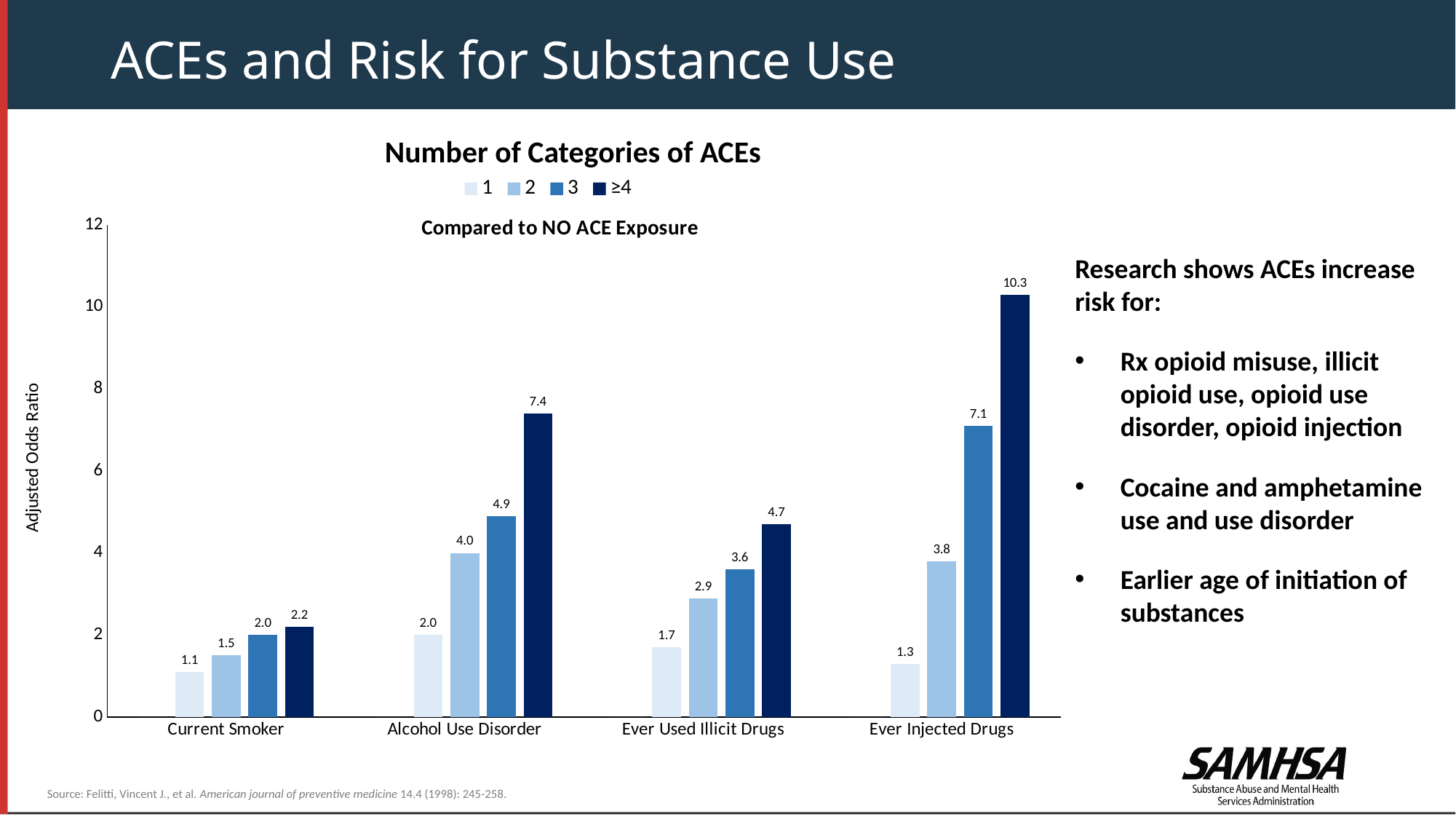
What kind of chart is shown on the slide? Bar chart Within the Ever Used Illicit Drugs category, do the values rise or fall as the number of ACE categories increases? Rise What is the adjusted odds ratio for Alcohol Use Disorder with 2 categories of ACEs? 4.0 What is the adjusted odds ratio for Current Smoker with 1 category of ACEs? 1.1 Which category has the highest adjusted odds ratio for the ≥4 ACEs series? Ever Injected Drugs Which category has the lowest adjusted odds ratio for the 3 ACEs series? Current Smoker What is the label of the y axis? Adjusted Odds Ratio What is the difference between the ≥4 and 1 ACEs values for Alcohol Use Disorder? 5.4 Which is larger: the 3 ACEs value for Ever Used Illicit Drugs or the 3 ACEs value for Ever Injected Drugs? Ever Injected Drugs How many categories are shown on the x axis? 4 What is the adjusted odds ratio for Ever Injected Drugs with ≥4 categories of ACEs? 10.3 How many series does the legend list? 4